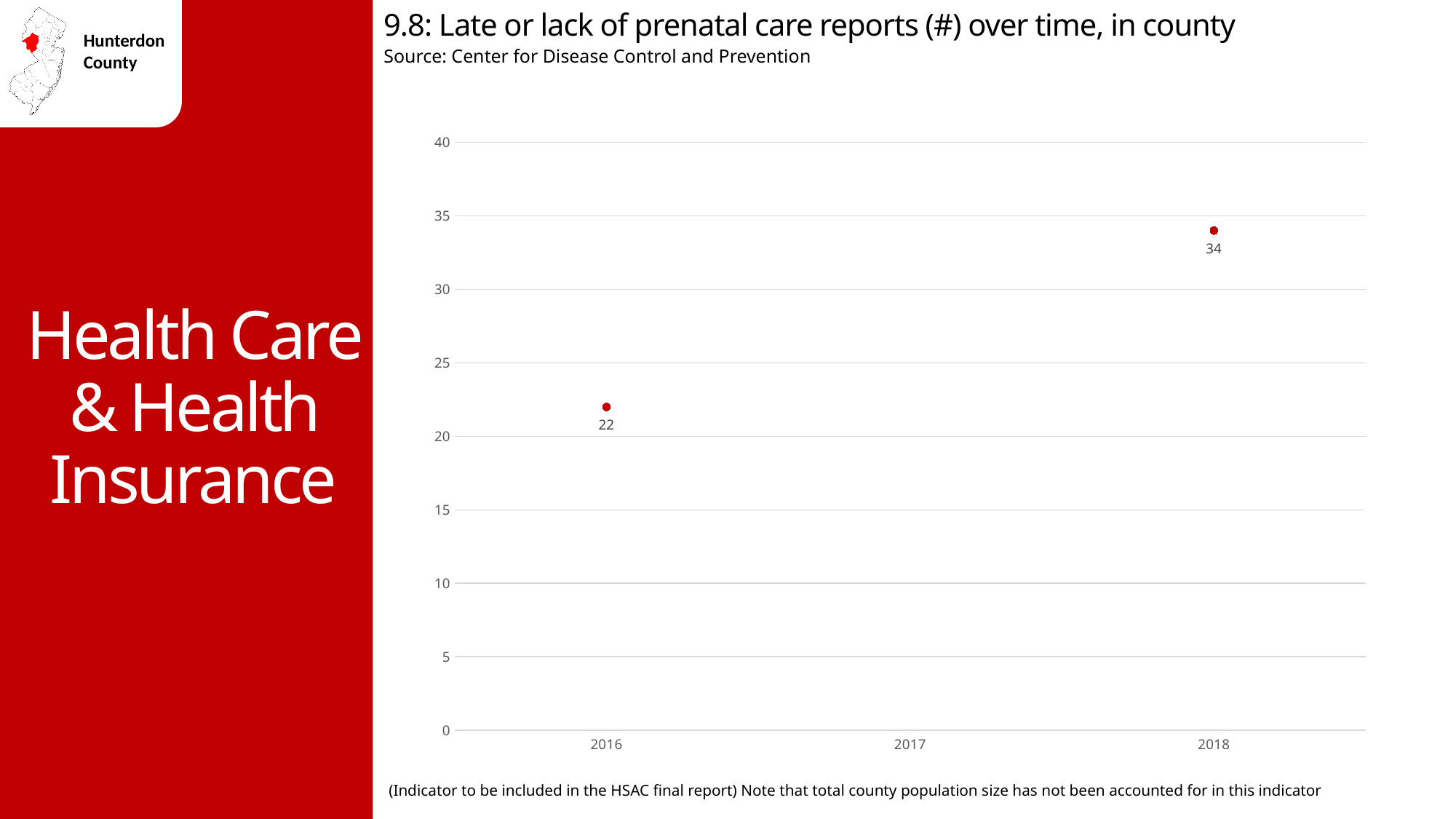
Which year has a larger value, 2016 or 2018? 2018 Is the value for 2016 greater or less than 25? less What is the number of late or lack of prenatal care reports in 2018? 34 What kind of chart is shown on the slide? Scatter chart Which year has the lowest number of late or lack of prenatal care reports? 2016 Is the value for 2018 greater or less than 30? greater Which year has the highest number of late or lack of prenatal care reports? 2018 What is the number of late or lack of prenatal care reports in 2016? 22 How many data points are plotted on the chart? 2 What is the difference between the 2018 and 2016 values? 12 What is the source of the data shown in the chart? Center for Disease Control and Prevention Do the values rise or fall from 2016 to 2018? Rise